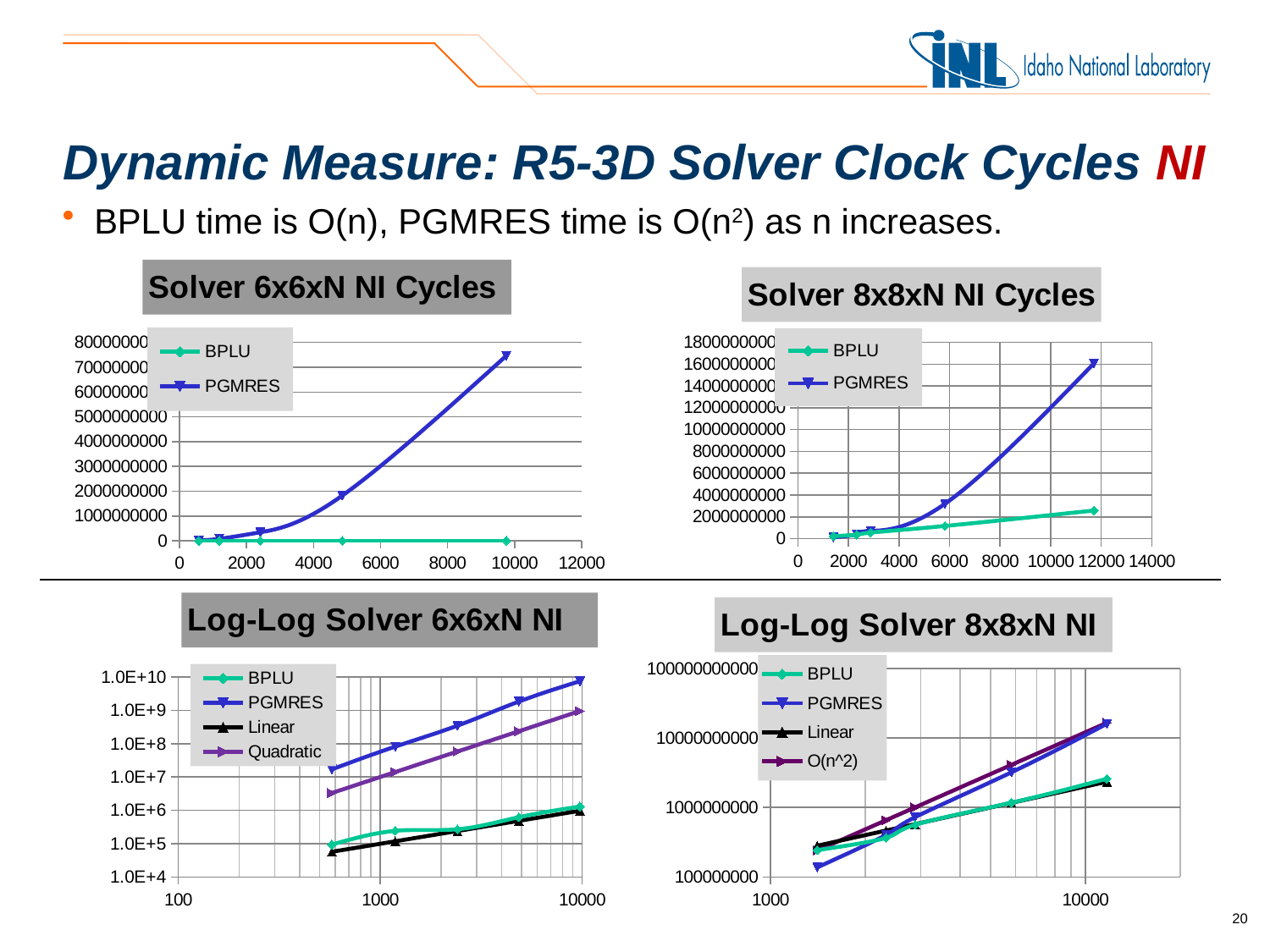
In the 'Solver 6x6xN NI Cycles' chart, is the rightmost PGMRES value greater or less than 6000000000? greater In the 'Log-Log Solver 6x6xN NI' chart, which series is highest at the rightmost point? PGMRES In the 'Solver 8x8xN NI Cycles' chart, at the largest N plotted, which series is higher, PGMRES or BPLU? PGMRES How many data points are plotted for the PGMRES series in the 'Solver 6x6xN NI Cycles' chart? 5 How many series does the legend of the 'Solver 6x6xN NI Cycles' chart list? 2 What is the title of the top-left chart on the slide? Solver 6x6xN NI Cycles What are the legend entries of the 'Log-Log Solver 8x8xN NI' chart? BPLU, PGMRES, Linear, O(n^2) What kind of chart is the 'Solver 6x6xN NI Cycles' chart? line chart In the 'Solver 8x8xN NI Cycles' chart, does the PGMRES series rise or fall as N increases? rise How many series does the legend of the 'Log-Log Solver 6x6xN NI' chart list? 4 In the 'Solver 8x8xN NI Cycles' chart, is the rightmost BPLU value greater or less than 4000000000? less In the 'Log-Log Solver 6x6xN NI' chart, is the rightmost PGMRES value greater or less than 1.0E+9? greater